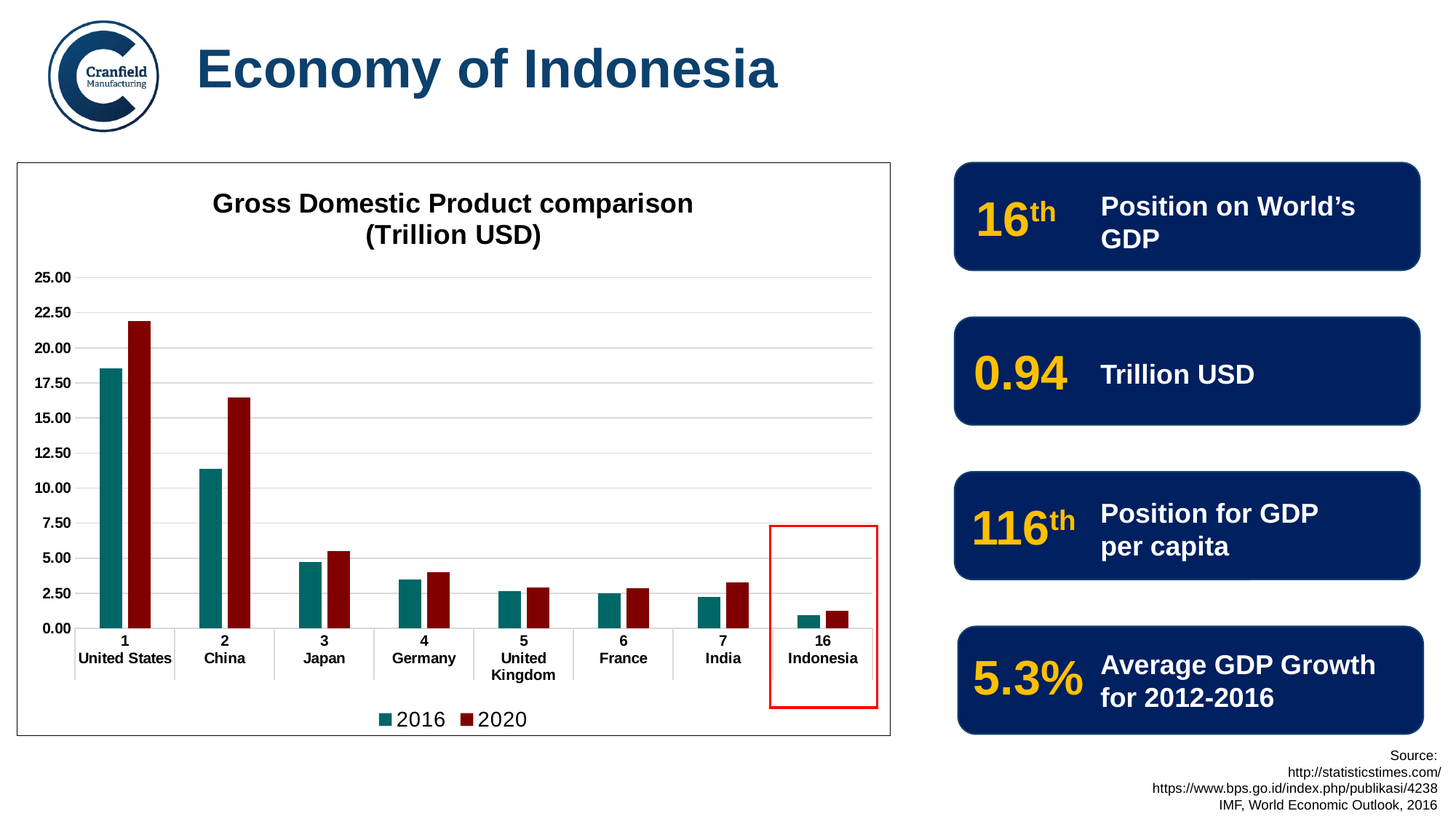
What kind of chart is shown on the slide? bar chart Do the 2016 values generally rise or fall moving from left to right along the x axis? fall How many countries are shown on the x axis of the chart? 8 Which country on the chart is highlighted with a red box? Indonesia Is the 2020 value for Germany greater or less than 5.00? less Is the 2016 value for United States greater or less than 15.00? greater Is the 2020 value for China greater or less than 15.00? greater How many series does the legend of the Gross Domestic Product comparison chart list? 2 Which country has the highest 2020 bar in the chart? United States Which is larger: the 2016 value for China or the 2020 value for Japan? 2016 value for China Which country has the lowest 2016 bar in the chart? Indonesia Which is larger: the 2016 value for Germany or the 2016 value for India? 2016 value for Germany